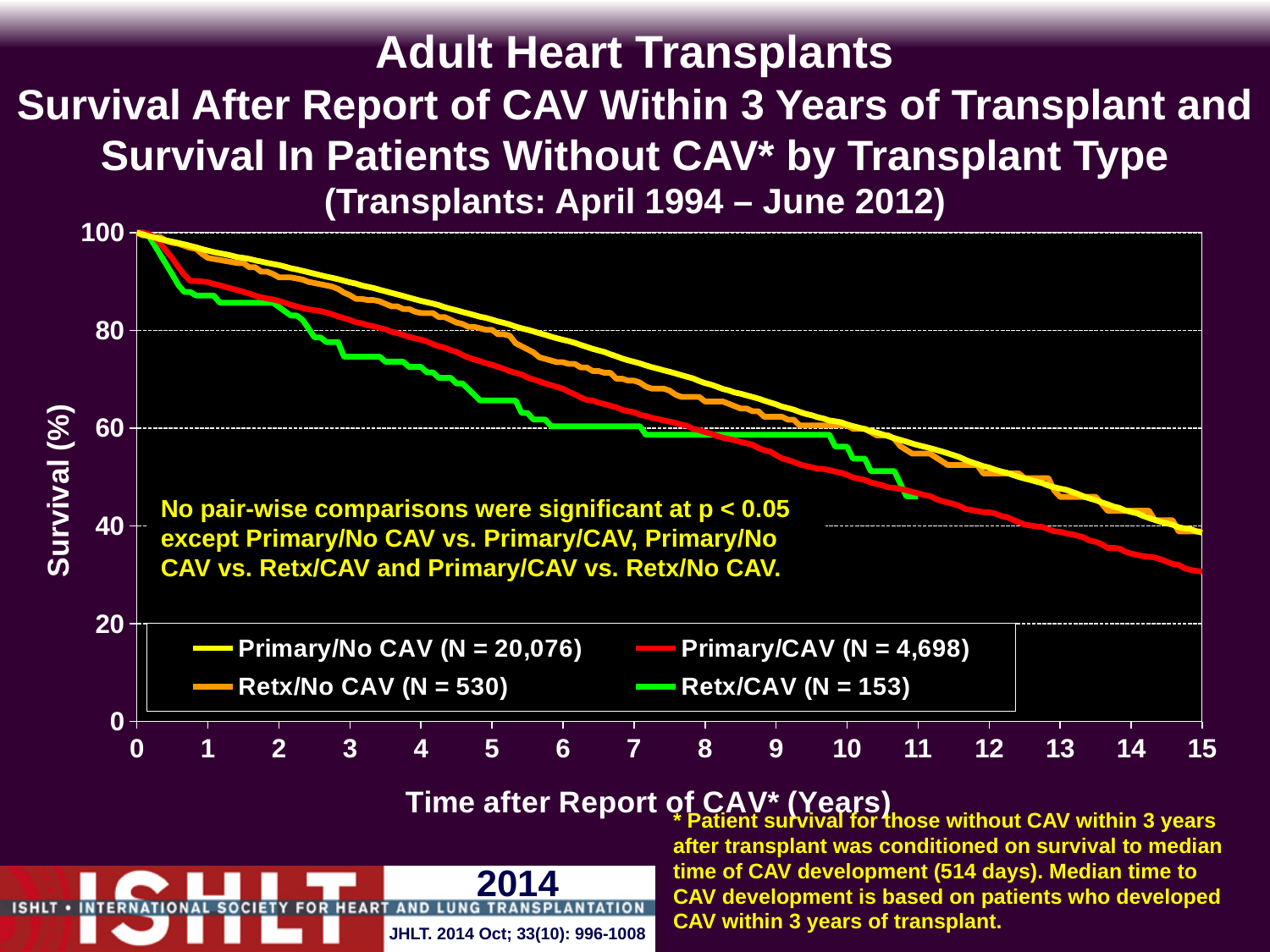
What is the N for the Retx/CAV group shown in the legend? 153 Is the survival value for Primary/CAV at 5 years greater or less than 60? greater Is the survival value for Primary/CAV at 15 years greater or less than 40? less What is the N for the Primary/CAV group shown in the legend? 4,698 Do the survival curves rise or fall as time after report of CAV increases? fall How many series does the legend list? 4 At 15 years, which has higher survival: Primary/No CAV or Primary/CAV? Primary/No CAV What colour is the Retx/CAV line? green Which group has the lowest survival at 15 years? Primary/CAV Is the survival value for Retx/CAV at 3 years greater or less than 80? less What is the N for the Primary/No CAV group shown in the legend? 20,076 What kind of chart is shown on the slide? line chart